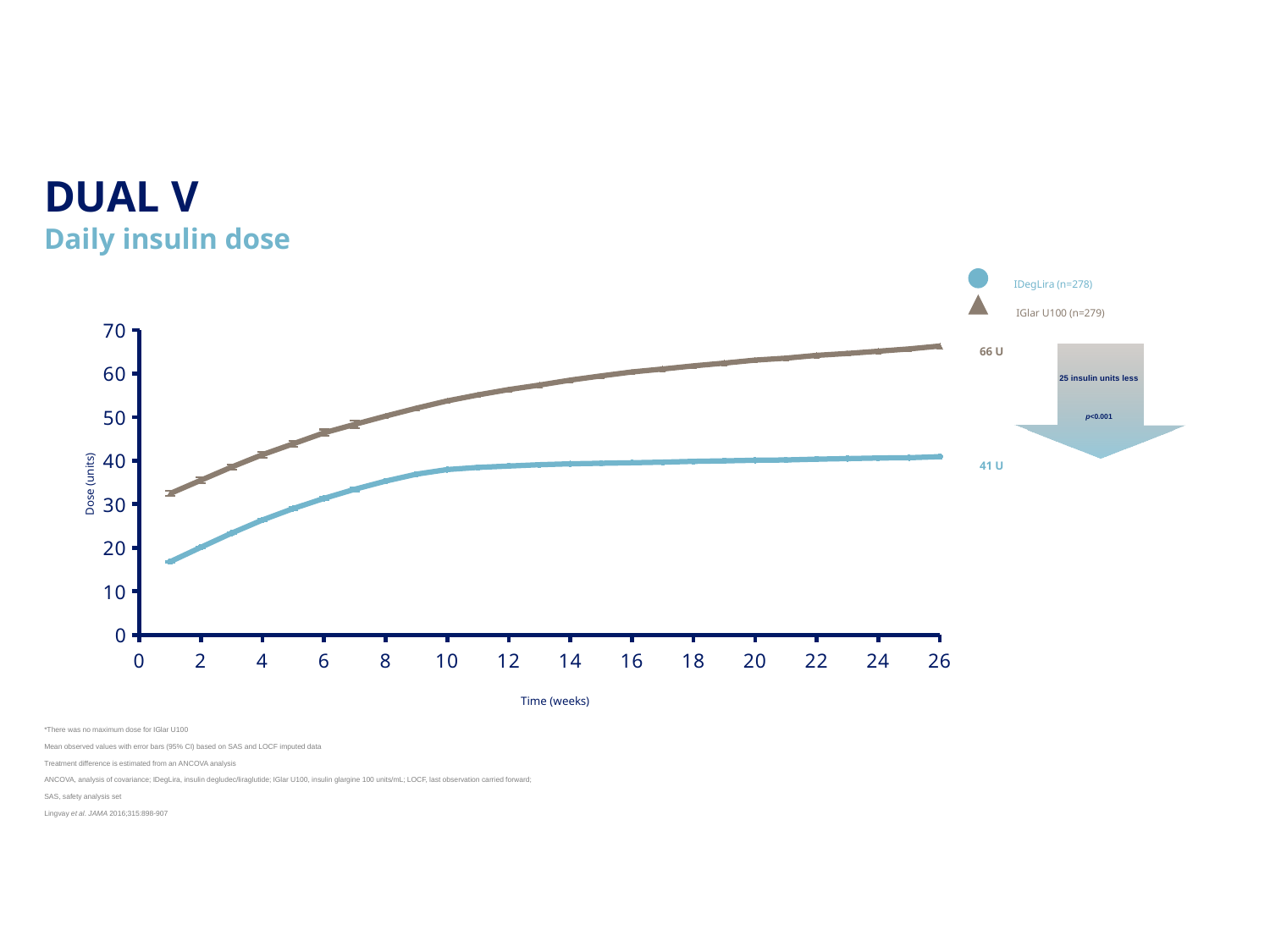
Do the daily insulin doses rise or fall over the weeks for both series? rise What p-value is shown for the treatment difference? p<0.001 Is the IDegLira dose at week 1 greater or less than 20 units? less What kind of chart is shown on the slide? line chart How many series does the legend list? 2 Is the IGlar U100 dose at week 10 greater or less than 50 units? greater What is the daily insulin dose for IGlar U100 at the end of the study (week 26)? 66 U What is the label of the x axis? Time (weeks) Is the IDegLira dose at week 26 greater or less than 50 units? less By how many insulin units is the IDegLira dose lower than the IGlar U100 dose at week 26? 25 insulin units less What is the daily insulin dose for IDegLira at the end of the study (week 26)? 41 U Which series has the higher daily insulin dose at week 26, IDegLira or IGlar U100? IGlar U100